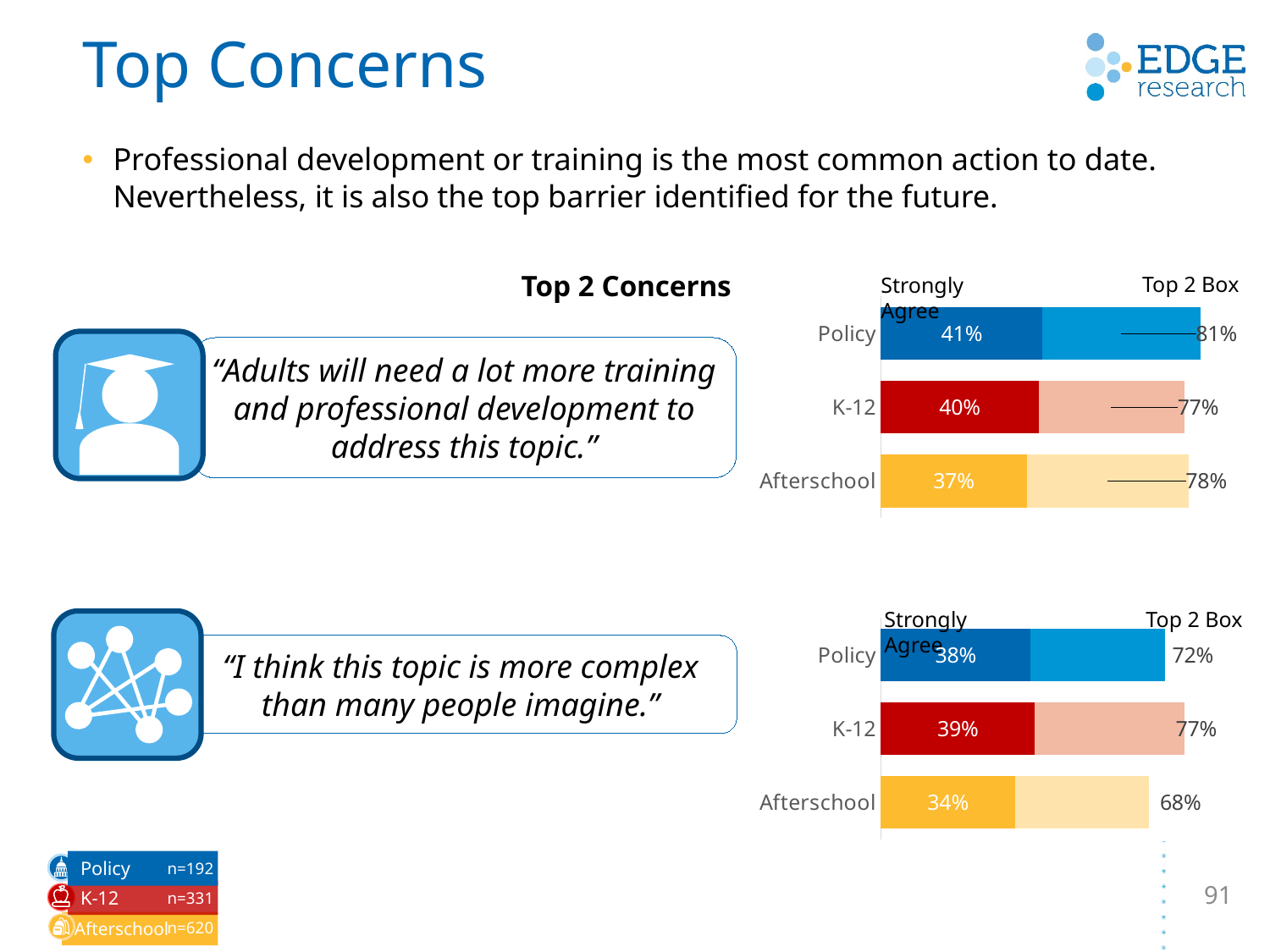
In the bottom chart ("I think this topic is more complex..."), which group has the highest Top 2 Box value? K-12 In the top chart ("Adults will need a lot more training..."), which group has the lowest Strongly Agree value? Afterschool In the bottom chart ("I think this topic is more complex..."), which is larger: the Strongly Agree value for Policy or for K-12? K-12 In the top chart ("Adults will need a lot more training..."), what is the Strongly Agree value for Policy? 41% In the top chart ("Adults will need a lot more training..."), what is the Top 2 Box value for K-12? 77% In the bottom chart ("I think this topic is more complex..."), what is the difference between the Top 2 Box values for K-12 and Afterschool? 9% In the top chart ("Adults will need a lot more training..."), what is the difference between the Top 2 Box values for Policy and K-12? 4% In the top chart ("Adults will need a lot more training..."), what is the Top 2 Box value for Afterschool? 78% In the bottom chart ("I think this topic is more complex..."), what is the Top 2 Box value for Policy? 72% In the top chart ("Adults will need a lot more training..."), which group has the highest Top 2 Box value? Policy In the bottom chart ("I think this topic is more complex..."), what is the Strongly Agree value for Afterschool? 34% What type of chart is used to show the Top 2 Concerns results? Bar chart